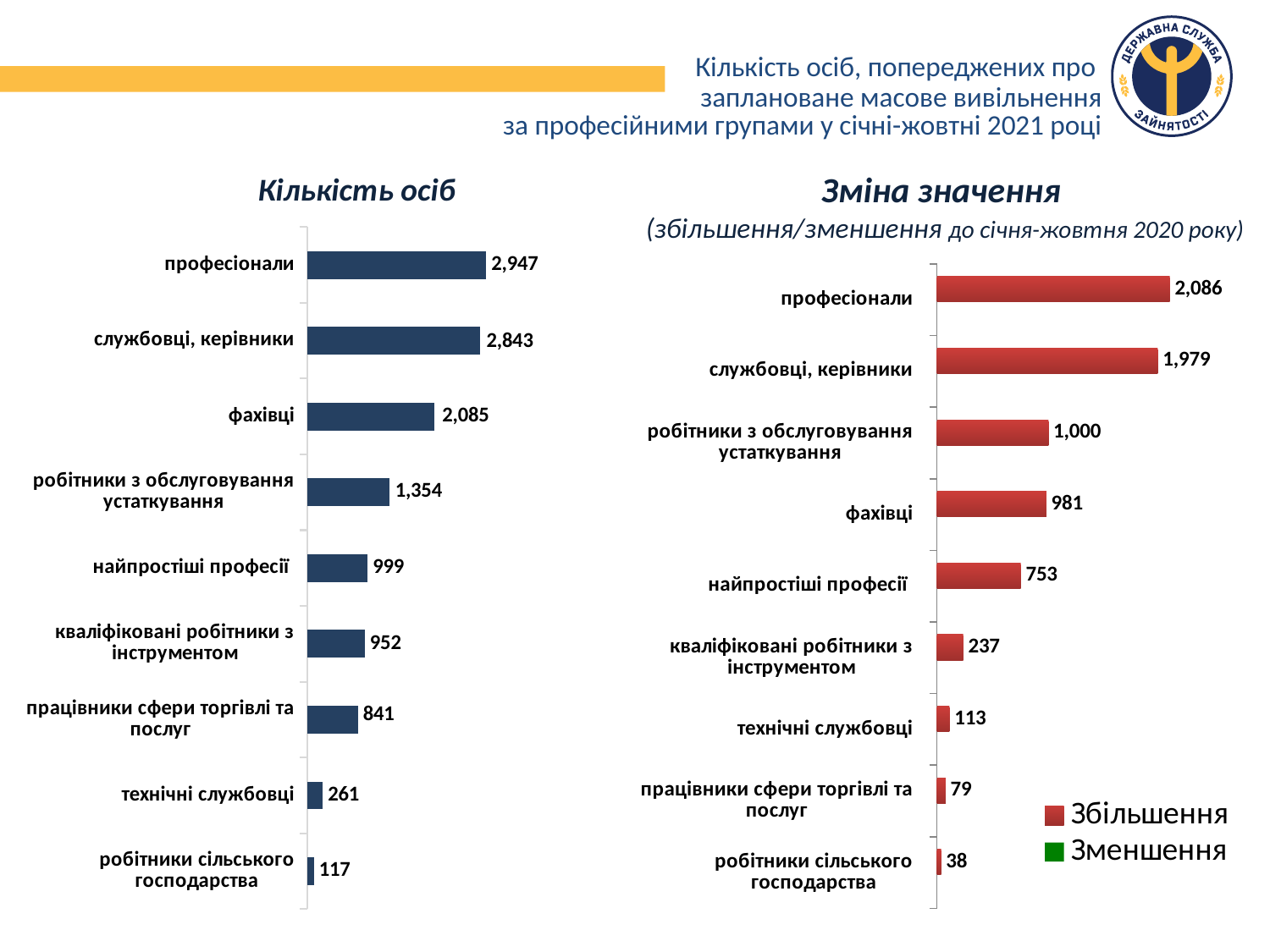
What type of chart is the chart titled "Кількість осіб"? bar chart In the chart titled "Кількість осіб", which category has the lowest value? робітники сільського господарства In the chart titled "Кількість осіб", how many categories are shown? 9 In the chart titled "Зміна значення", how many entries does the legend list? 2 In the chart titled "Кількість осіб", what is the difference between професіонали and службовці, керівники? 104 In the chart titled "Кількість осіб", what is the value for технічні службовці? 261 In the chart titled "Зміна значення", what is the value for робітники з обслуговування устаткування? 1,000 In the chart titled "Зміна значення", which category has the lowest value? робітники сільського господарства In the chart titled "Кількість осіб", which category has the highest value? професіонали In the chart titled "Зміна значення", which is larger: технічні службовці or працівники сфери торгівлі та послуг? технічні службовці In the chart titled "Кількість осіб", what is the value for фахівці? 2,085 In the chart titled "Зміна значення", what is the value for найпростіші професії? 753